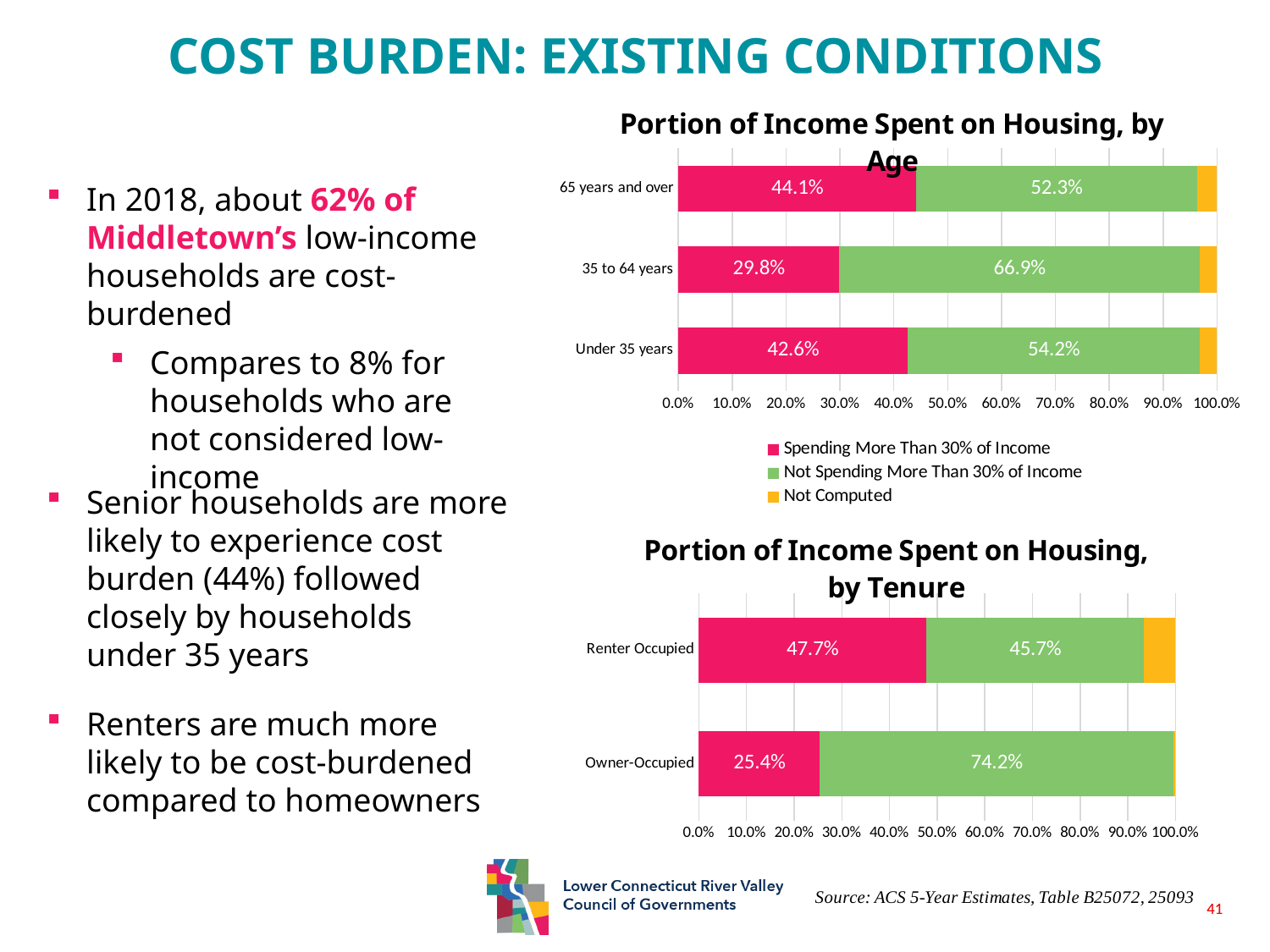
In the 'Portion of Income Spent on Housing, by Age' chart, how many age groups are shown? 3 In the 'Portion of Income Spent on Housing, by Tenure' chart, which tenure type has the larger share spending more than 30% of income, Renter Occupied or Owner-Occupied? Renter Occupied In the 'Portion of Income Spent on Housing, by Tenure' chart, what is the difference between the 'Spending More Than 30% of Income' values for Renter Occupied and Owner-Occupied? 22.3% In the 'Portion of Income Spent on Housing, by Tenure' chart, what percentage of owner-occupied households are spending more than 30% of income? 25.4% In the 'Portion of Income Spent on Housing, by Age' chart, what percentage of households 65 years and over are spending more than 30% of income? 44.1% In the 'Portion of Income Spent on Housing, by Age' chart, how many series does the legend list? 3 What type of chart is the 'Portion of Income Spent on Housing, by Tenure' chart? Stacked bar chart In the 'Portion of Income Spent on Housing, by Tenure' chart, what percentage of renter-occupied households are not spending more than 30% of income? 45.7% In the 'Portion of Income Spent on Housing, by Age' chart, what percentage of households aged 35 to 64 years are not spending more than 30% of income? 66.9% In the 'Portion of Income Spent on Housing, by Age' chart, which age group has the highest share not spending more than 30% of income? 35 to 64 years In the 'Portion of Income Spent on Housing, by Age' chart, what is the difference between the 'Spending More Than 30% of Income' values for 65 years and over and Under 35 years? 1.5% In the 'Portion of Income Spent on Housing, by Age' chart, which age group has the lowest share spending more than 30% of income? 35 to 64 years